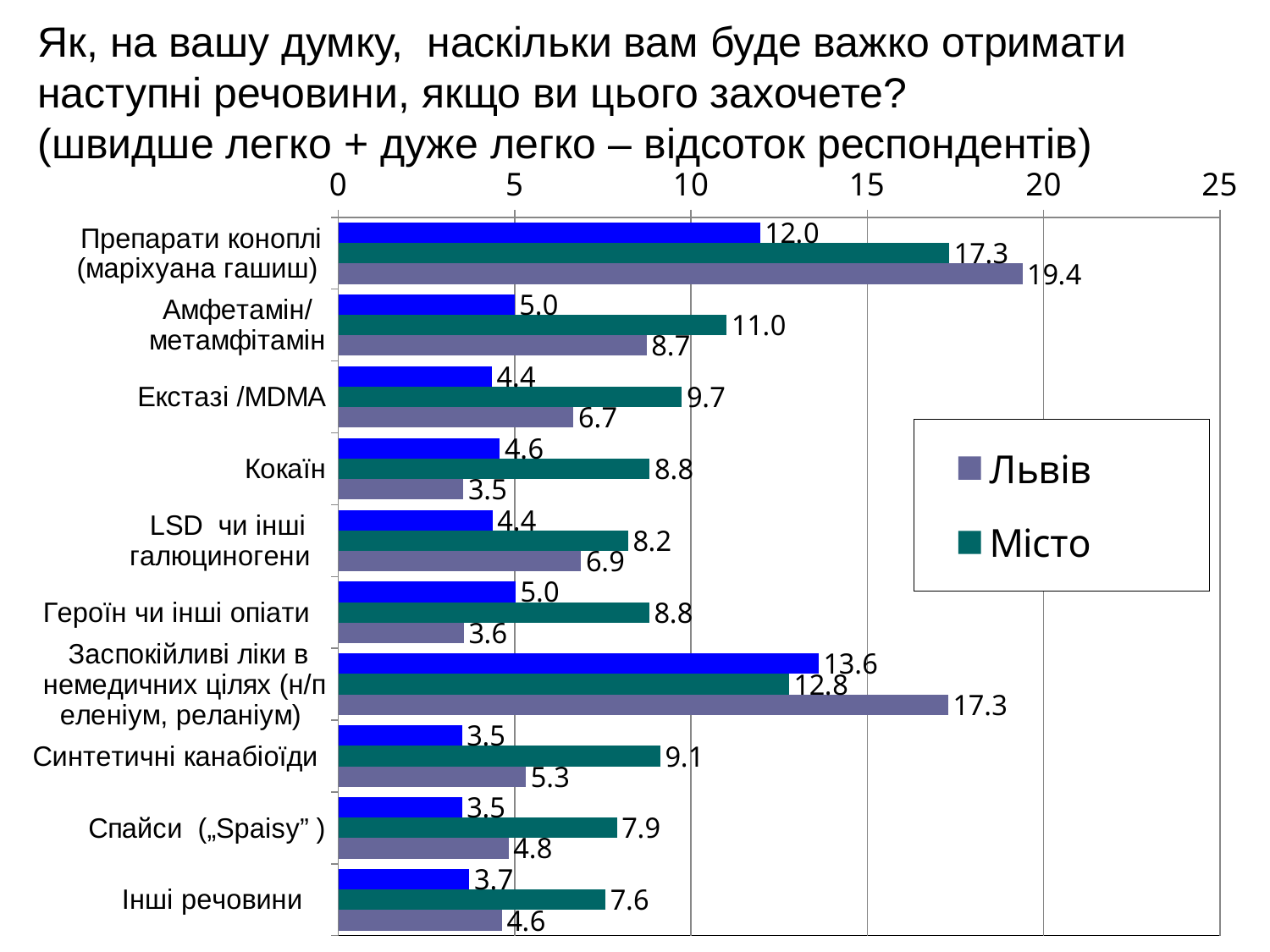
How many categories are shown on the chart? 10 Which category has the lowest value for Львів? Кокаїн What is the value for Місто for Кокаїн? 8.8 What is the difference between the Місто and Львів values for Екстазі /MDMA? 3.0 What is the value for Місто for Синтетичні канабіоїди? 9.1 Which category has the highest value for Місто? Препарати коноплі (маріхуана гашиш) Which is larger for Героїн чи інші опіати: the Місто value or the Львів value? Місто What kind of chart is shown on the slide? bar chart Is the Львів value for Заспокійливі ліки в немедичних цілях greater or less than 15? greater How many series does the legend list? 2 What is the value for Львів for Препарати коноплі (маріхуана гашиш)? 19.4 What is the value for Львів for Спайси („Spaisy”)? 4.8